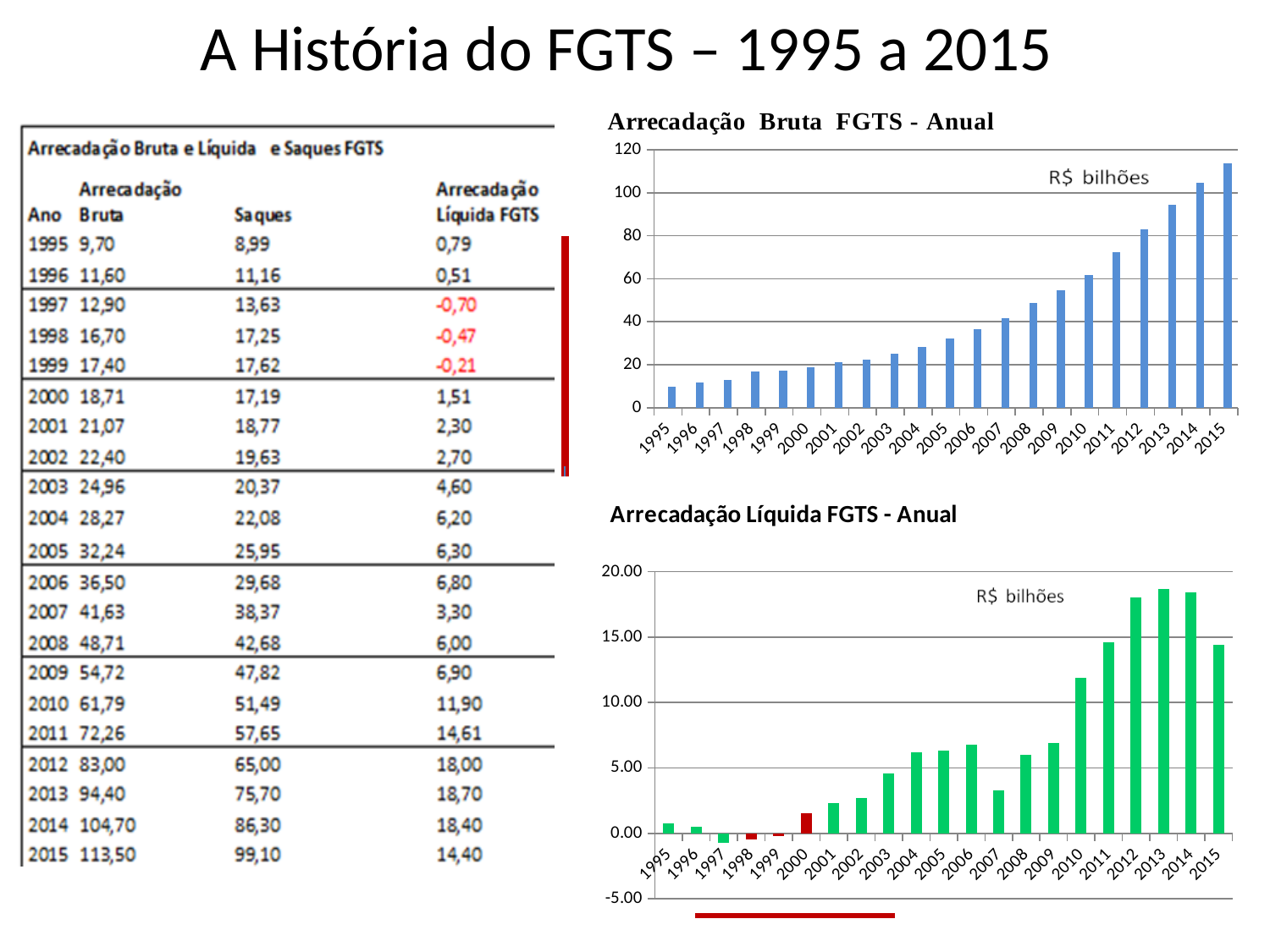
In the 'Arrecadação Líquida FGTS - Anual' chart, is the value for 2007 greater or less than 5.00? less How many years are plotted in the 'Arrecadação Bruta FGTS - Anual' chart? 21 In the 'Arrecadação Líquida FGTS - Anual' chart, how many years have a bar below zero? 3 What type of chart is the 'Arrecadação Bruta FGTS - Anual' chart? Bar chart In the 'Arrecadação Bruta FGTS - Anual' chart, is the value for 2015 greater or less than 100? greater In the 'Arrecadação Bruta FGTS - Anual' chart, which year has the lowest bar? 1995 What unit is shown inside the plot area of the 'Arrecadação Bruta FGTS - Anual' chart? R$ bilhões In the 'Arrecadação Bruta FGTS - Anual' chart, do the values generally rise or fall from 1995 to 2015? Rise In the 'Arrecadação Bruta FGTS - Anual' chart, is the value for 2008 greater or less than 60? less In the 'Arrecadação Líquida FGTS - Anual' chart, which is larger, the value for 2006 or the value for 2007? 2006 In the 'Arrecadação Bruta FGTS - Anual' chart, which year has the highest bar? 2015